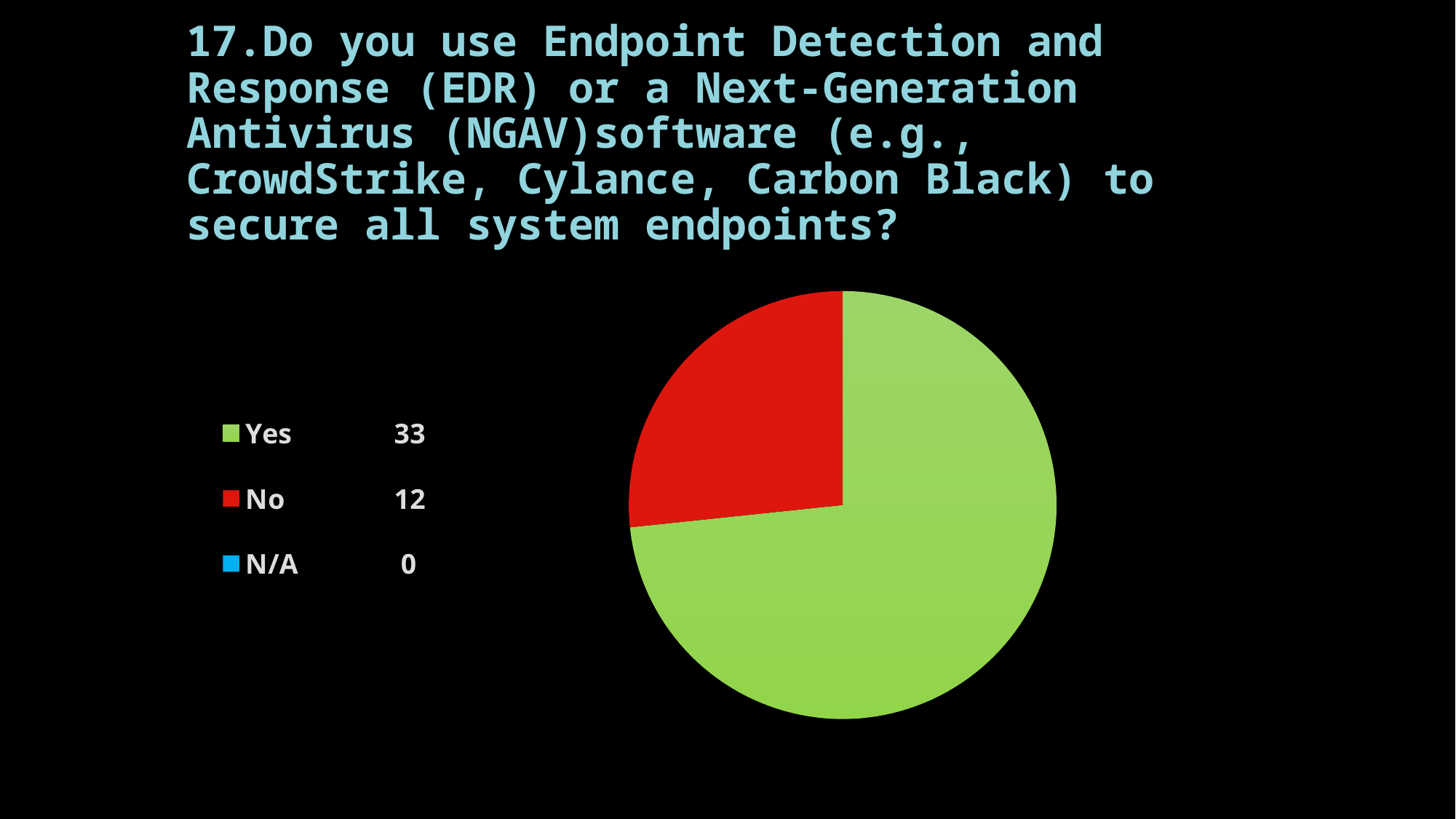
What kind of chart is shown on the slide? pie chart Which category has the lowest value? N/A What colour is the No slice of the pie? red How many categories does the legend list? 3 What colour is the Yes slice of the pie? green Which is larger, the Yes count or the No count? Yes What is the total number of responses across all categories? 45 Which category has the highest value? Yes What is the value for N/A? 0 How many respondents answered Yes? 33 How many respondents answered No? 12 What is the difference between the Yes and No counts? 21